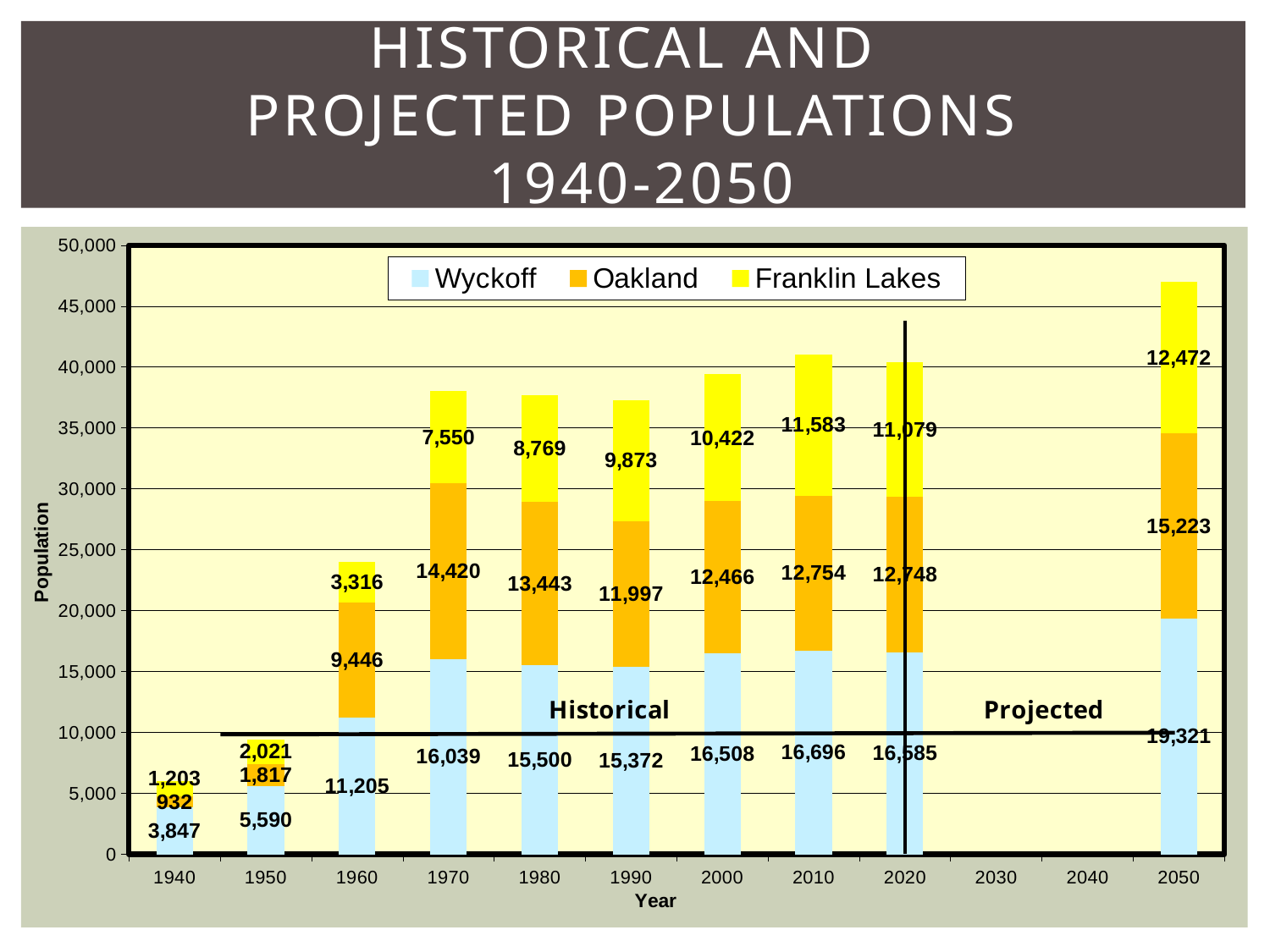
What kind of chart is shown on the slide? Stacked bar chart Which series is shown in yellow in the legend? Franklin Lakes What is the total population of the three towns in 2050? 47,016 How many series does the legend list? 3 Which is larger, the Oakland population in 1970 or in 1980? 1970 In which year is the Wyckoff population highest? 2050 What is the Wyckoff population shown for 1970? 16,039 In which year is the Franklin Lakes population lowest? 1940 What is the Oakland population shown for 1960? 9,446 What is the total population of the three towns in 1940? 5,982 What is the difference between the Wyckoff population in 2050 and in 2020? 2,736 What is the Franklin Lakes population shown for 2010? 11,583